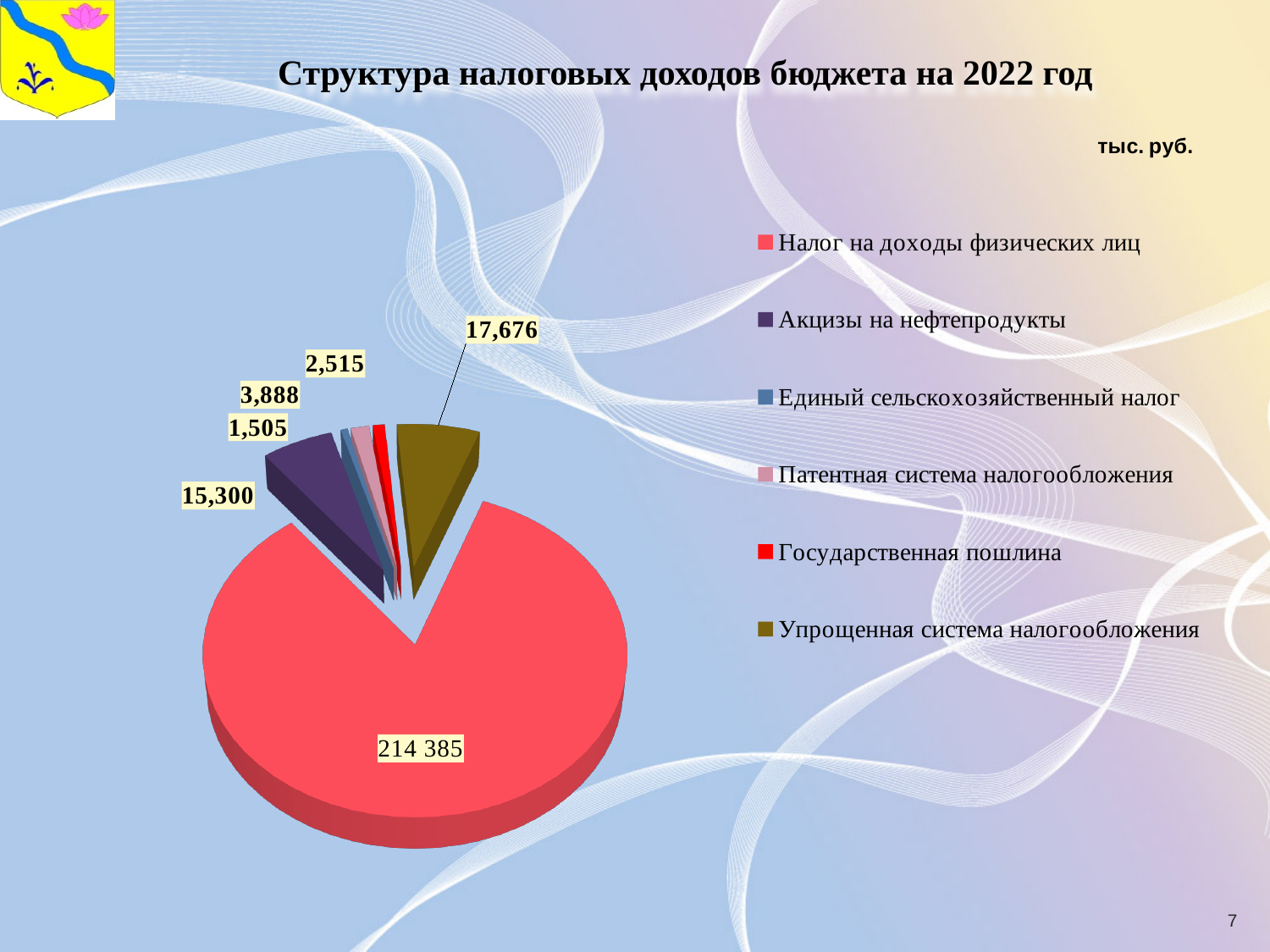
What kind of chart is shown on the slide? pie chart What unit is stated for the values on the slide? тыс. руб. What is the difference between the values for Упрощенная система налогообложения and Акцизы на нефтепродукты? 2,376 Which category has the largest slice of the pie? Налог на доходы физических лиц What is the value for Упрощенная система налогообложения? 17,676 What is the value for Акцизы на нефтепродукты? 15,300 What is the value for Налог на доходы физических лиц? 214 385 Which is larger, the value for Патентная система налогообложения or the value for Государственная пошлина? Патентная система налогообложения Which category has the smallest slice of the pie? Единый сельскохозяйственный налог What is the value for Единый сельскохозяйственный налог? 1,505 How many categories does the legend list? 6 What is the value for Патентная система налогообложения? 3,888